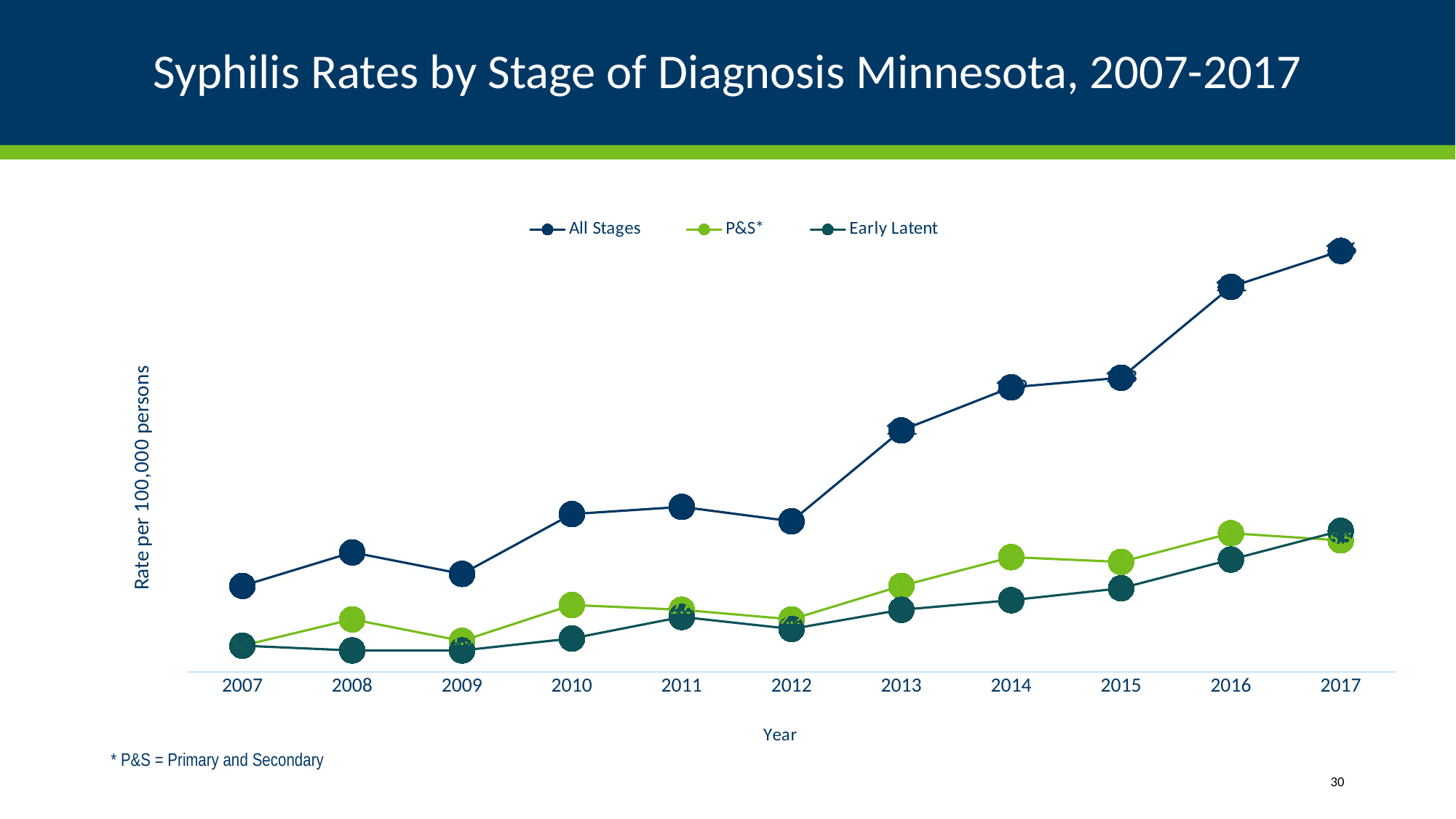
How many series does the legend list? 3 In 2013, which series has the higher rate, All Stages or P&S*? All Stages Which year has the highest All Stages rate? 2017 In 2016, which series has the higher rate, P&S* or Early Latent? P&S* Which year has the highest Early Latent rate? 2017 In 2008, which series has the higher rate, P&S* or Early Latent? P&S* What is the label of the y axis? Rate per 100,000 persons Overall, does the All Stages rate rise or fall from 2007 to 2017? Rise What is the title of the chart? Syphilis Rates by Stage of Diagnosis Minnesota, 2007-2017 What kind of chart is shown on the slide? Line chart How many years are plotted along the x axis? 11 Which year has the lowest All Stages rate? 2007